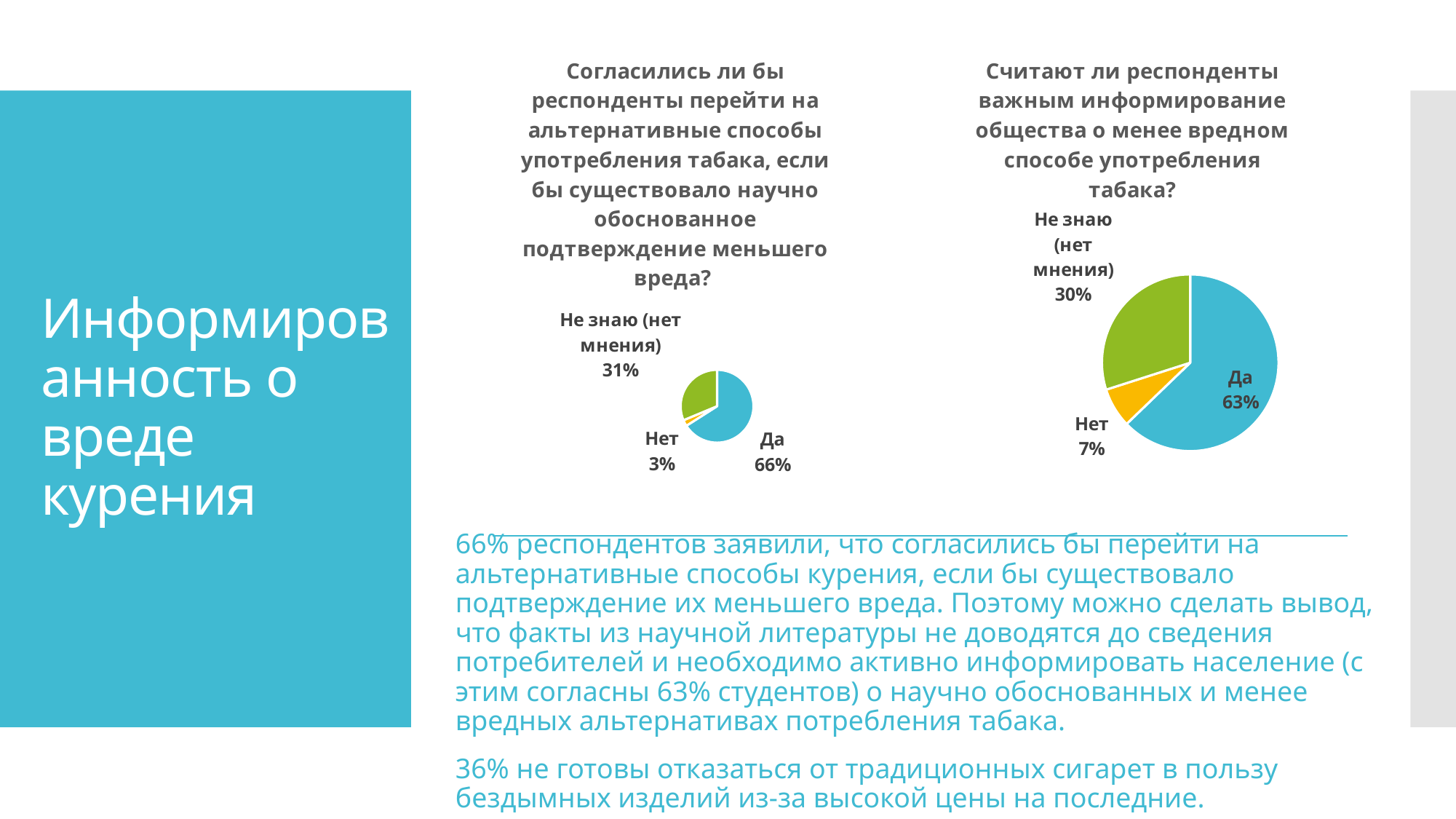
Which is larger: the "Нет" share in the left pie chart or the "Нет" share in the right pie chart? The right pie chart (7%) In the right pie chart, which answer has the smallest share? Нет In the right pie chart, what share of respondents answered "Нет"? 7% In the left pie chart, which answer has the largest share? Да In the left pie chart, what is the difference in percentage points between "Да" and "Не знаю (нет мнения)"? 35 In the left pie chart, what share of respondents answered "Не знаю (нет мнения)"? 31% In the right pie chart ("Считают ли респонденты важным информирование общества..."), what share of respondents answered "Да"? 63% In the right pie chart, what share of respondents answered "Не знаю (нет мнения)"? 30% How many slices does the right pie chart have? 3 What type of chart is used on this slide? Pie chart In the left pie chart, what share of respondents answered "Нет"? 3% In the left pie chart ("Согласились ли бы респонденты перейти на альтернативные способы употребления табака..."), what share of respondents answered "Да"? 66%